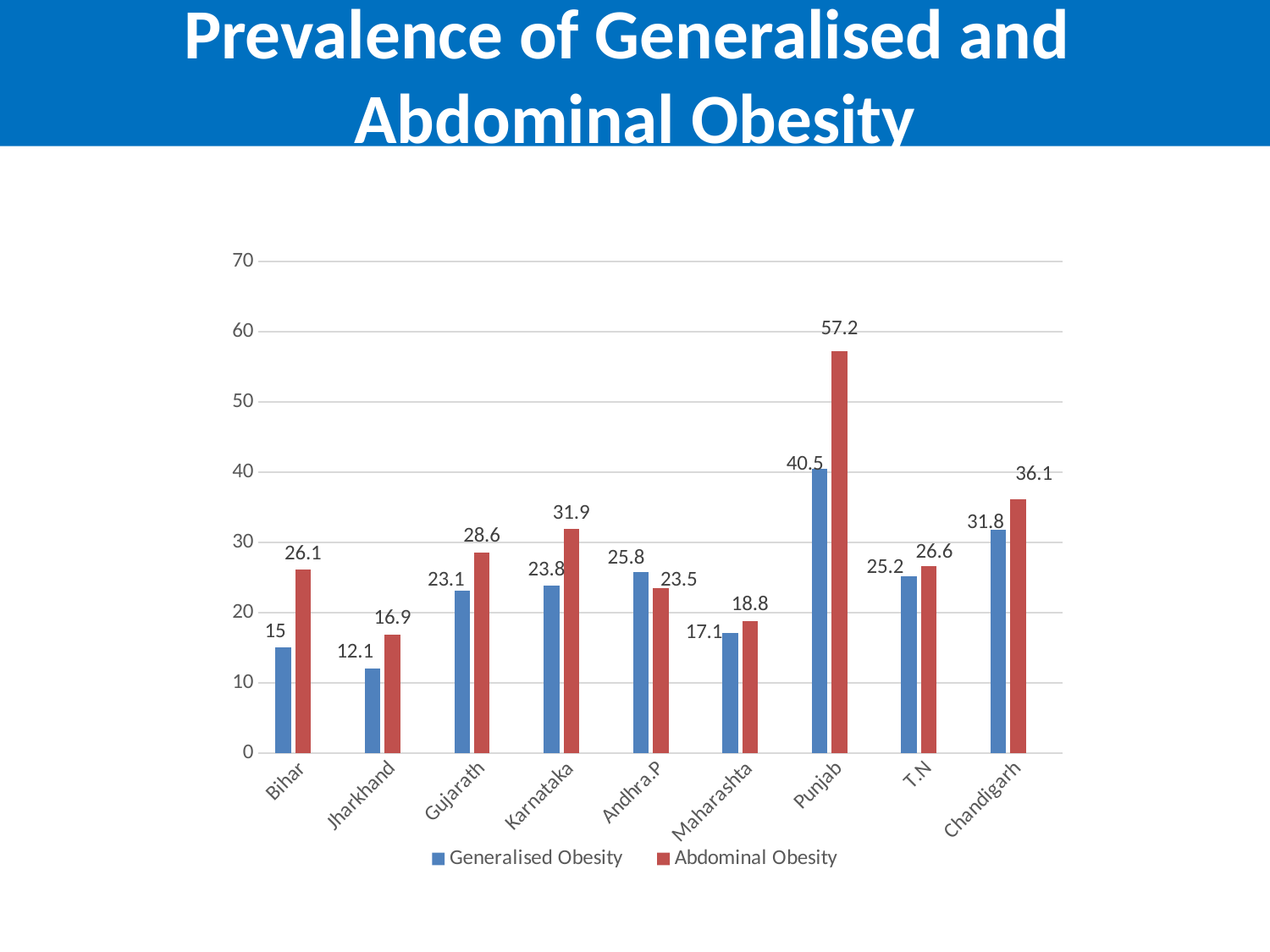
What is the difference between the Abdominal Obesity and Generalised Obesity values for Punjab? 16.7 What is the Abdominal Obesity value for Karnataka? 31.9 Is the Abdominal Obesity value for Chandigarh greater or less than 30? greater Which state has the highest Abdominal Obesity value? Punjab Which colour represents Abdominal Obesity in the chart? red How many series does the legend list? 2 For Andhra.P, which is larger: Generalised Obesity or Abdominal Obesity? Generalised Obesity What is the Generalised Obesity value for Punjab? 40.5 How many states are shown on the x axis? 9 Which state has the lowest Generalised Obesity value? Jharkhand What kind of chart is shown on the slide? bar chart What is the Generalised Obesity value for Jharkhand? 12.1